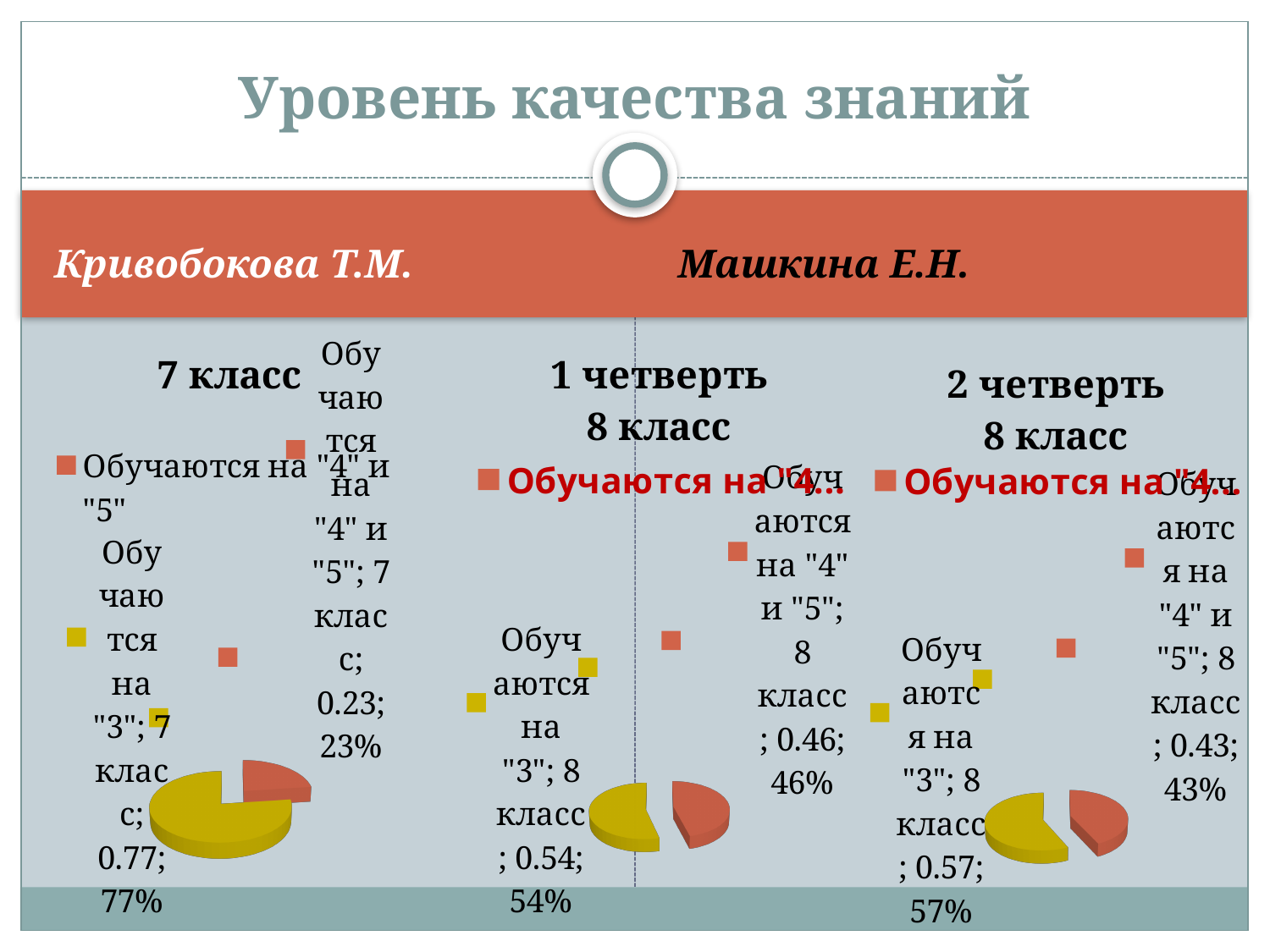
How many slices does the "7 класс" pie chart have? 2 In the "2 четверть 8 класс" chart, what is the difference in percentage points between the "Обучаются на "3"" slice and the "Обучаются на "4" и "5"" slice? 14 In the "7 класс" chart, what percentage is shown for the slice "Обучаются на "4" и "5""? 23% How many pie charts are shown on the slide? 3 In the "2 четверть 8 класс" chart, what percentage is shown for the slice "Обучаются на "4" и "5""? 43% In the "7 класс" chart, what percentage is shown for the slice "Обучаются на "3""? 77% What kind of chart is the "7 класс" chart? pie chart In the "7 класс" chart, which slice is the largest? Обучаются на "3" In the "1 четверть 8 класс" chart, which slice is larger: "Обучаются на "3"" or "Обучаются на "4" и "5""? Обучаются на "3" In the "2 четверть 8 класс" chart, what percentage is shown for the slice "Обучаются на "3""? 57% In the "1 четверть 8 класс" chart, what percentage is shown for the slice "Обучаются на "3""? 54% In the "1 четверть 8 класс" chart, what percentage is shown for the slice "Обучаются на "4" и "5""? 46%